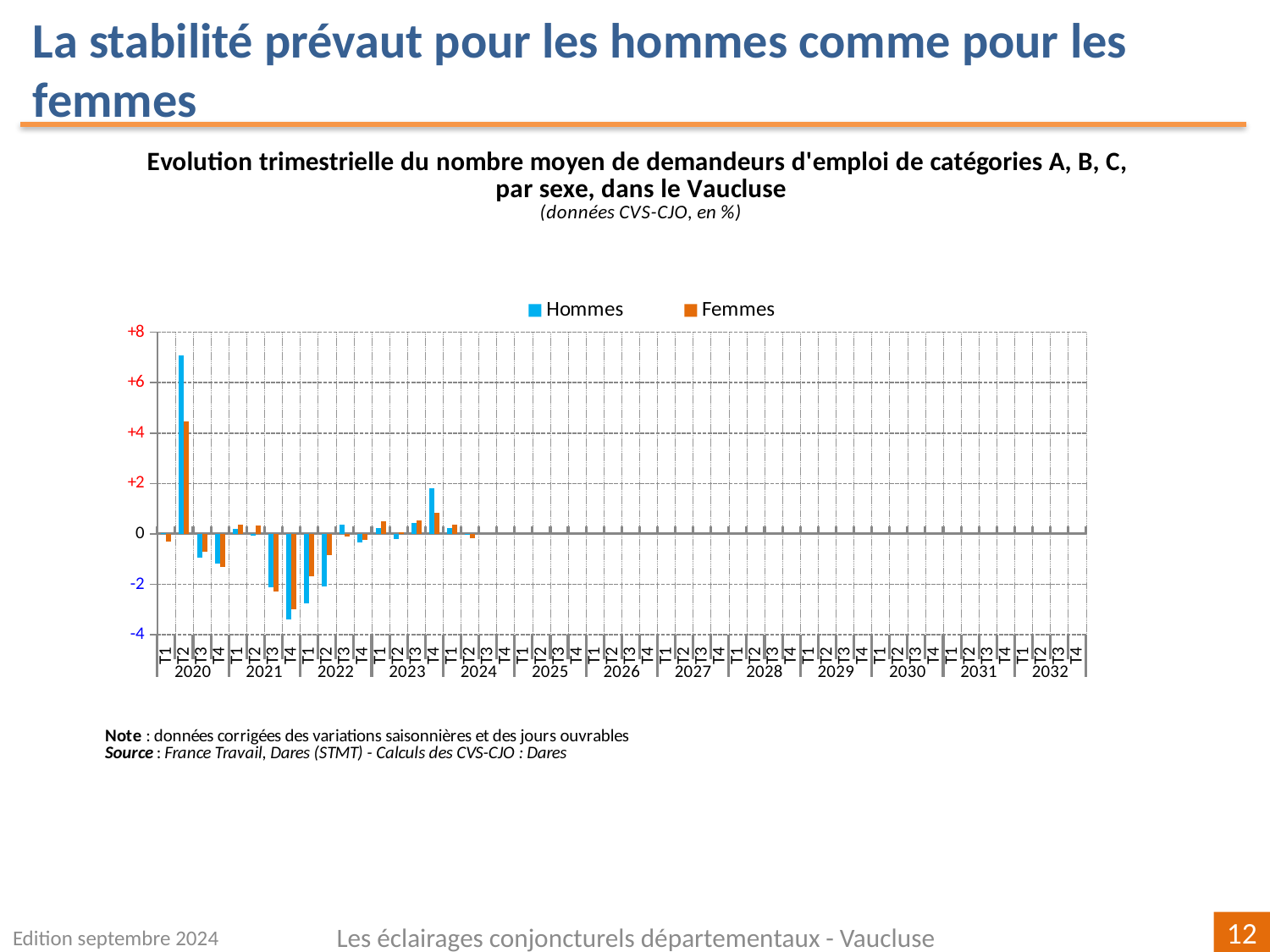
How many series does the legend list? 2 Is the value for Femmes in T2 2020 greater or less than +2? greater Which series has the single highest bar on the chart? Hommes What are the two series named in the legend? Hommes and Femmes Is the value for Hommes in T2 2020 greater or less than +6? greater In which quarter does the Hommes series reach its highest value? T2 2020 In which quarter does the Hommes series reach its lowest value? T4 2021 What kind of chart is shown on the slide? bar chart Which colour represents the Femmes series? orange In T2 2020, which series has the larger value, Hommes or Femmes? Hommes How many years are labelled along the x axis? 13